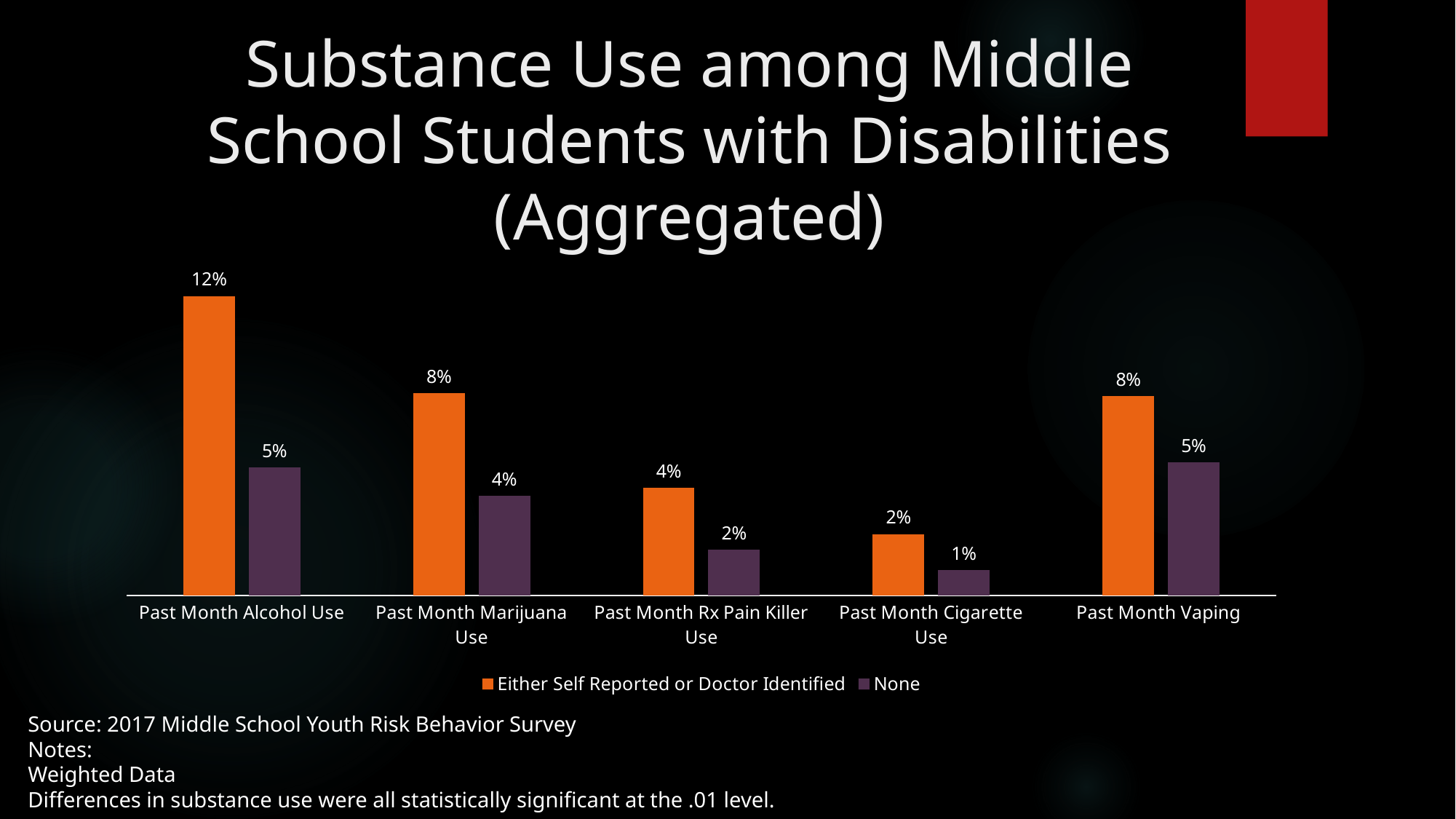
What colour are the bars for the None series? Purple How many series does the legend list? 2 What is the value for Past Month Cigarette Use in the None series? 1% Which is larger for Past Month Rx Pain Killer Use: the Either Self Reported or Doctor Identified value or the None value? Either Self Reported or Doctor Identified How many categories are shown on the x axis? 5 What is the difference between the Either Self Reported or Doctor Identified value and the None value for Past Month Marijuana Use? 4% What is the value for Past Month Alcohol Use in the Either Self Reported or Doctor Identified series? 12% What is the value for Past Month Vaping in the None series? 5% What is the difference between the Either Self Reported or Doctor Identified value and the None value for Past Month Alcohol Use? 7% Which category has the lowest value in the None series? Past Month Cigarette Use What kind of chart is shown on the slide? Bar chart Which category has the highest value in the Either Self Reported or Doctor Identified series? Past Month Alcohol Use